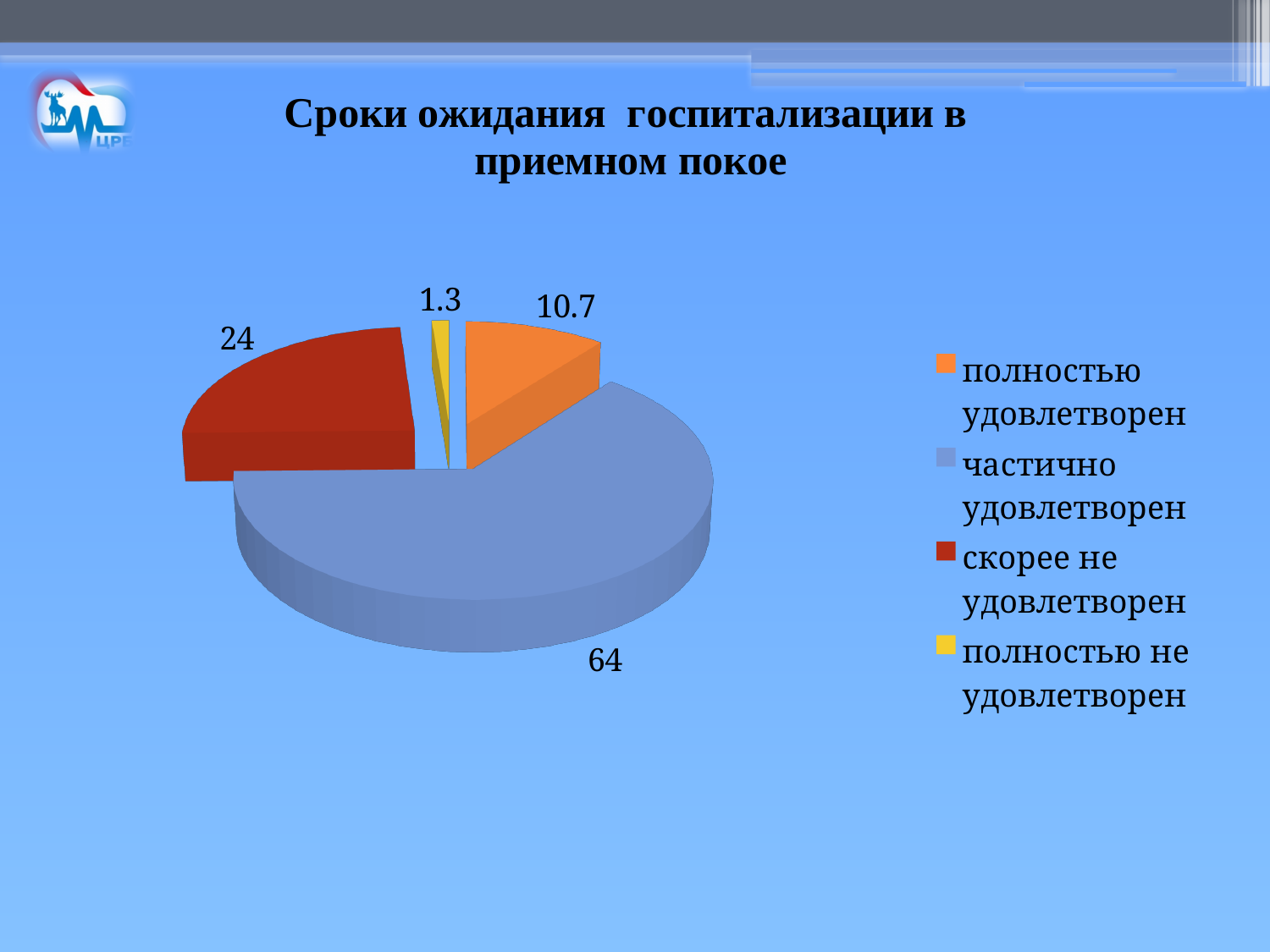
What value is shown for the slice 'частично удовлетворен'? 64 Which is larger: the value for 'скорее не удовлетворен' or the value for 'полностью удовлетворен'? скорее не удовлетворен How many slices does the pie chart have? 4 What is the difference between the values for 'скорее не удовлетворен' and 'полностью удовлетворен'? 13.3 What value is shown for the slice 'полностью не удовлетворен'? 1.3 What kind of chart is shown on the slide? pie chart What value is shown for the slice 'полностью удовлетворен'? 10.7 What is the difference between the values for 'частично удовлетворен' and 'скорее не удовлетворен'? 40 What is the title of the chart? Сроки ожидания госпитализации в приемном покое Which category has the largest slice of the pie? частично удовлетворен Which category has the smallest slice of the pie? полностью не удовлетворен What value is shown for the slice 'скорее не удовлетворен'? 24